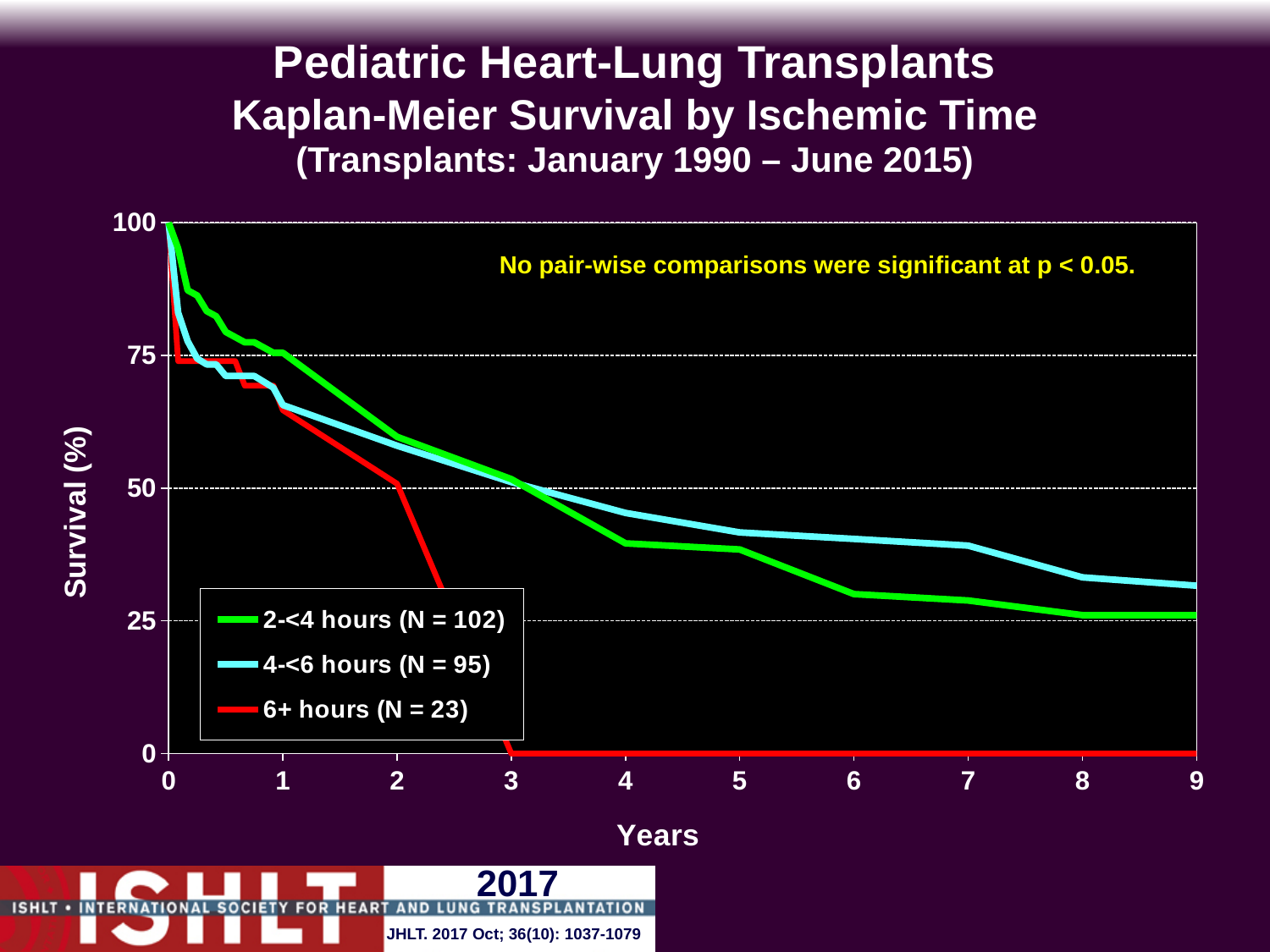
What kind of chart is shown on the slide? line chart What is the N for the 6+ hours group shown in the legend? 23 At year 6, which group has higher survival: 2-<4 hours or 4-<6 hours? 4-<6 hours What is the survival (%) for the 6+ hours group at year 5? 0 Does survival rise or fall as the years increase? fall Is the survival for the 2-<4 hours group at year 2 greater or less than 50? greater Which group has the highest survival at year 8? 4-<6 hours Which group has the lowest survival at year 5? 6+ hours Is the survival for the 6+ hours group at year 1 greater or less than 75? less What is the survival (%) for the 2-<4 hours group at year 0? 100 Is the survival for the 4-<6 hours group at year 5 greater or less than 50? less How many series does the legend list? 3